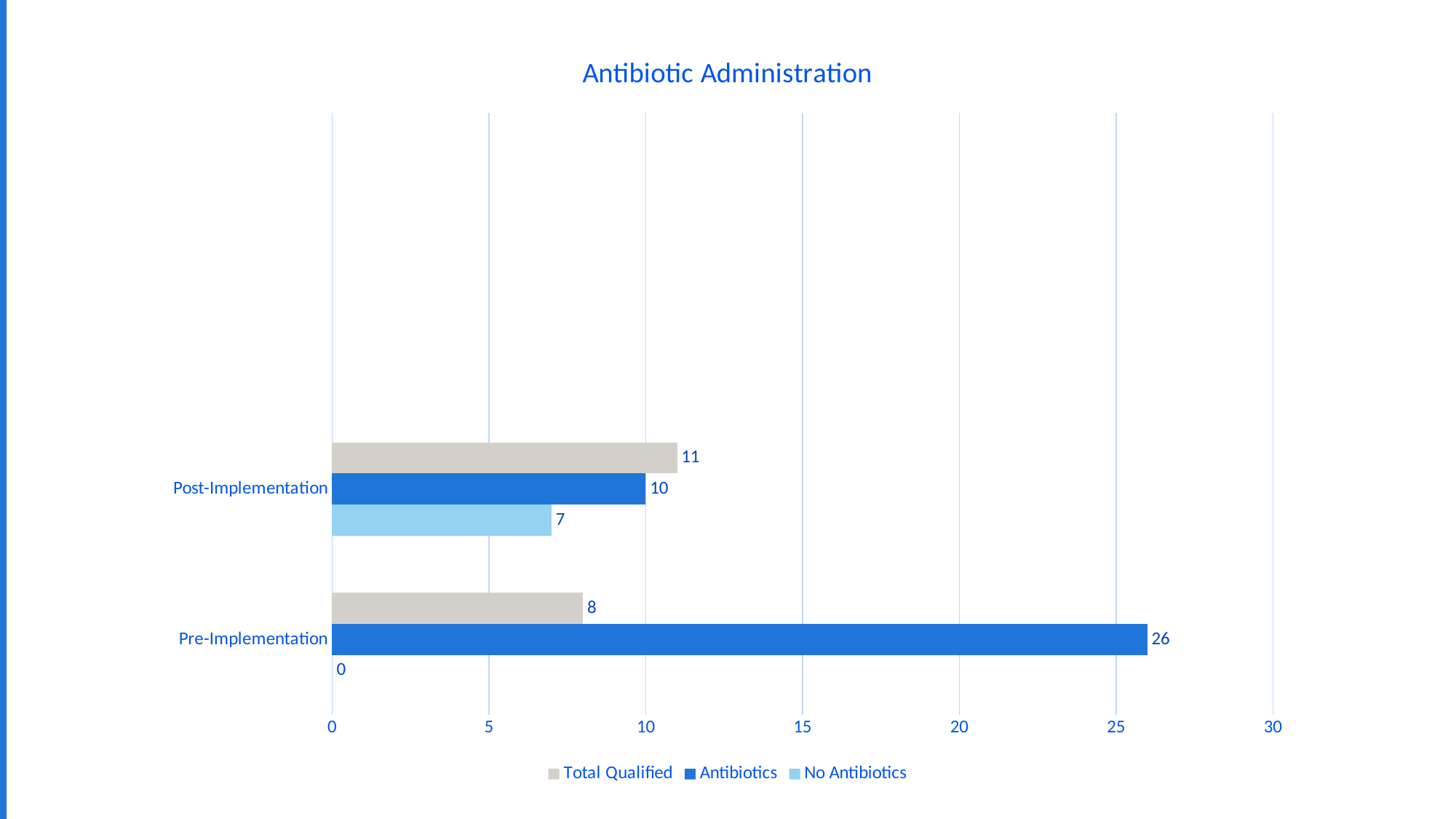
Which is larger: the Total Qualified value for Post-Implementation or for Pre-Implementation? Post-Implementation How many categories are shown on the chart? 2 Which category has the highest Antibiotics value? Pre-Implementation What is the Total Qualified value for Post-Implementation? 11 Which category has the lowest Total Qualified value? Pre-Implementation What is the Antibiotics value for Pre-Implementation? 26 What is the No Antibiotics value for Pre-Implementation? 0 What kind of chart is shown? Bar chart What is the title of the chart? Antibiotic Administration How many series does the legend list? 3 What is the difference between the Antibiotics values for Pre-Implementation and Post-Implementation? 16 What is the No Antibiotics value for Post-Implementation? 7